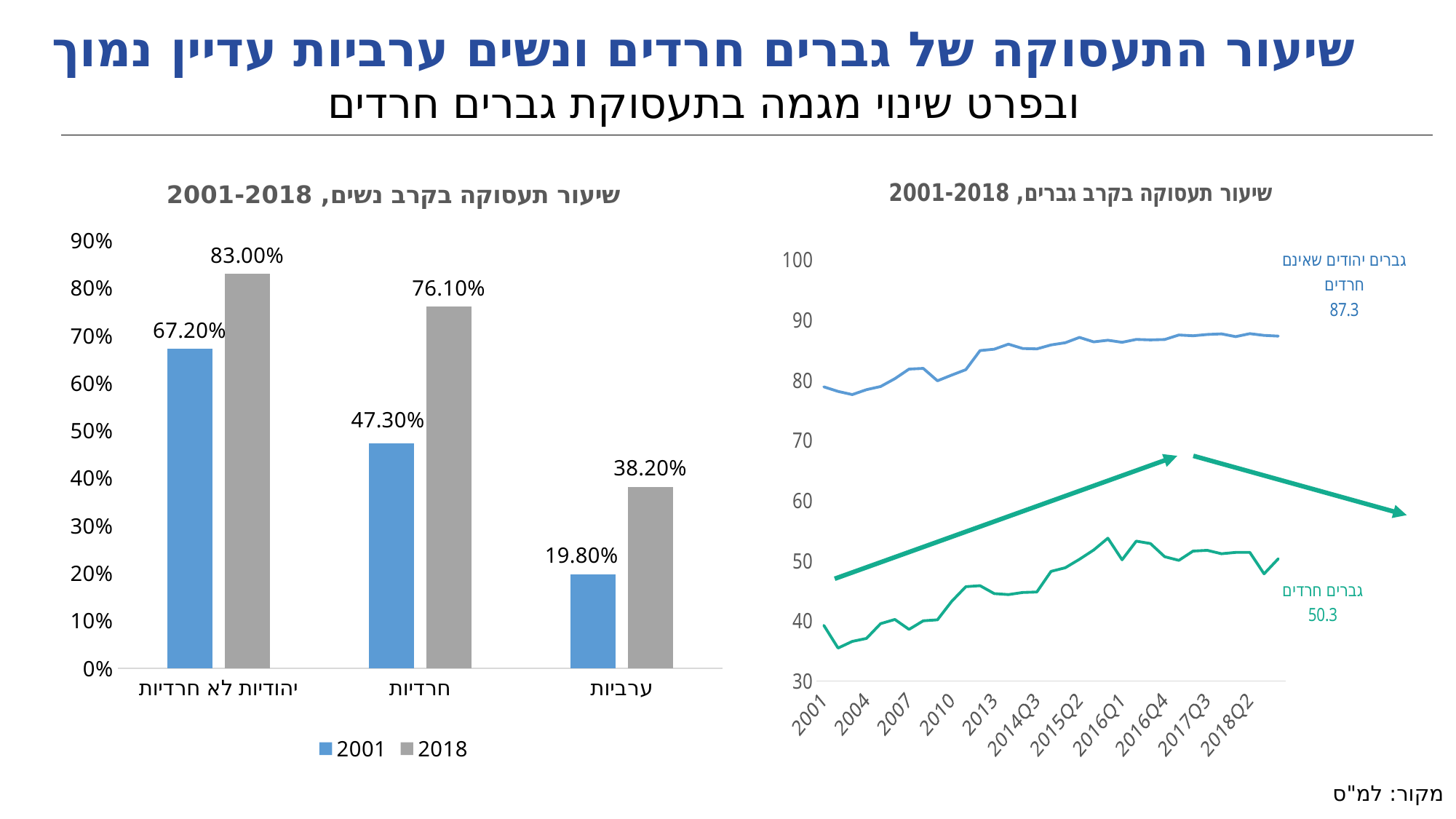
In the left chart (שיעור תעסוקה בקרב נשים, 2001-2018), which category has the highest value in 2018? יהודיות לא חרדיות In the right chart (שיעור תעסוקה בקרב גברים, 2001-2018), what is the final labelled value for גברים חרדים? 50.3 In the left chart (שיעור תעסוקה בקרב נשים, 2001-2018), what is the value for חרדיות in 2018? 76.10% In the right chart (שיעור תעסוקה בקרב גברים, 2001-2018), is the value for גברים חרדים in 2001 greater or less than 50? less In the right chart (שיעור תעסוקה בקרב גברים, 2001-2018), what is the final labelled value for גברים יהודים שאינם חרדים? 87.3 What kind of chart is the left chart (שיעור תעסוקה בקרב נשים, 2001-2018)? bar chart In the left chart (שיעור תעסוקה בקרב נשים, 2001-2018), what is the value for ערביות in 2001? 19.80% In the left chart (שיעור תעסוקה בקרב נשים, 2001-2018), how many series does the legend list? 2 In the left chart (שיעור תעסוקה בקרב נשים, 2001-2018), what is the difference between the 2018 and 2001 values for חרדיות? 28.80% In the left chart (שיעור תעסוקה בקרב נשים, 2001-2018), which category has the lowest value in 2001? ערביות In the left chart (שיעור תעסוקה בקרב נשים, 2001-2018), which is larger: the 2001 value for יהודיות לא חרדיות or the 2018 value for חרדיות? 2018 value for חרדיות In the left chart (שיעור תעסוקה בקרב נשים, 2001-2018), how many categories are shown on the x axis? 3